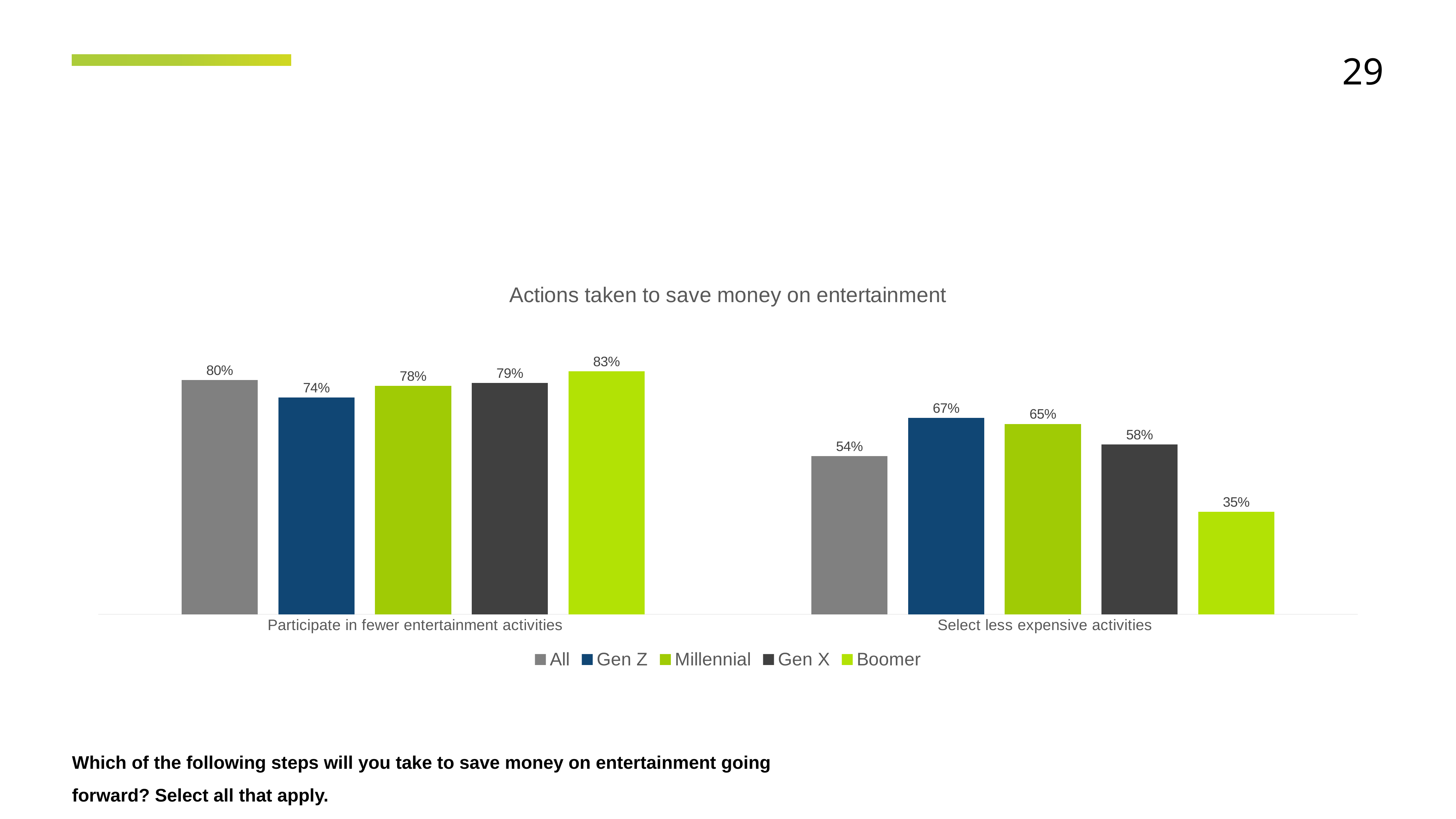
What is the difference between the Boomer values for 'Participate in fewer entertainment activities' and 'Select less expensive activities'? 48 percentage points How many series does the legend list? 5 Which is larger under 'Select less expensive activities': Gen Z or Gen X? Gen Z What is the title of the chart? Actions taken to save money on entertainment What is the value for Gen Z under 'Select less expensive activities'? 67% Which series has the highest value under 'Participate in fewer entertainment activities'? Boomer Which series has the lowest value under 'Select less expensive activities'? Boomer What is the value for Boomer under 'Participate in fewer entertainment activities'? 83% What is the difference between the Millennial and Gen Z values under 'Participate in fewer entertainment activities'? 4 percentage points What kind of chart is shown on the slide? Bar chart How many categories are shown on the x axis? 2 What is the value for All under 'Select less expensive activities'? 54%